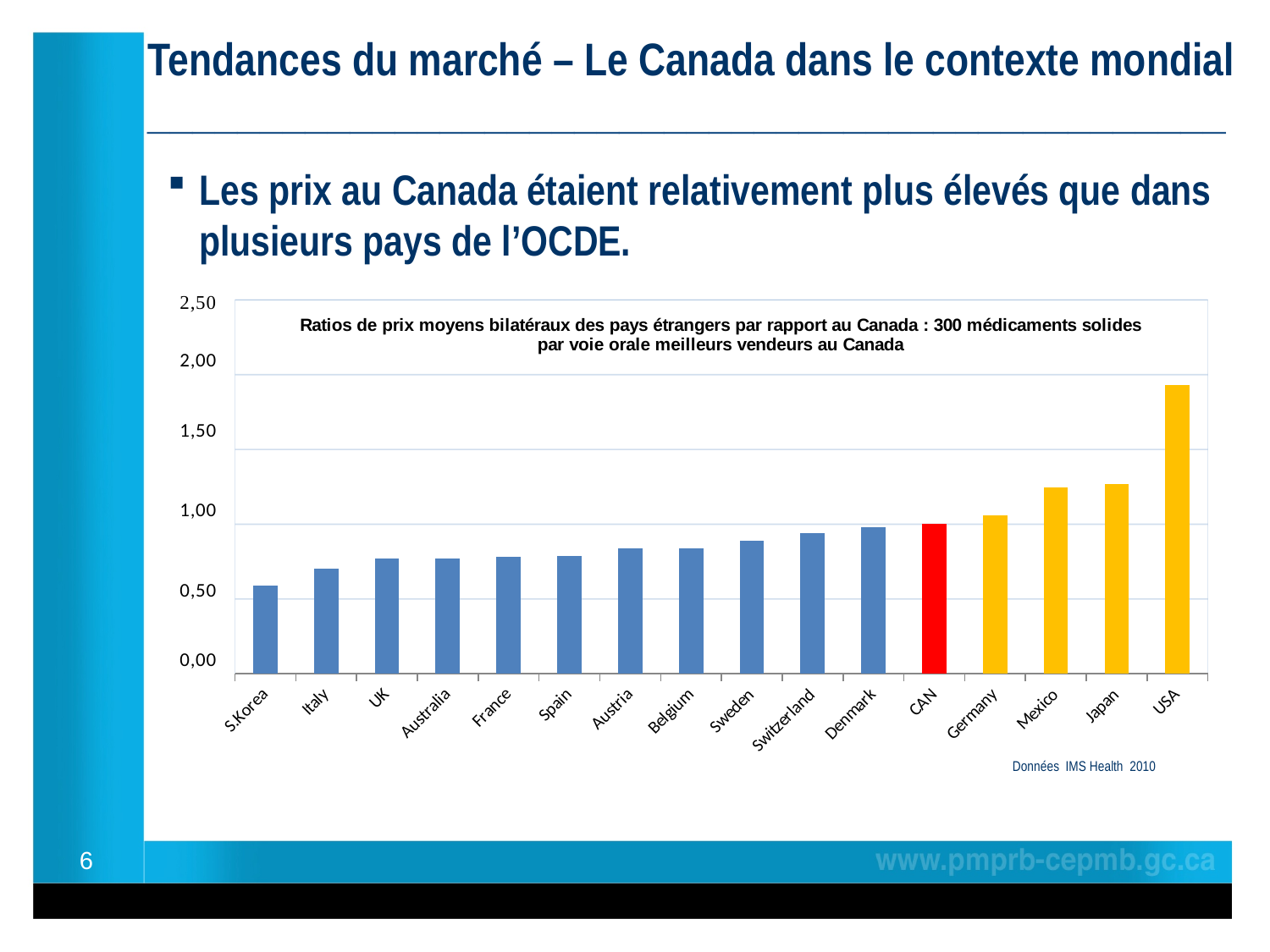
What kind of chart is shown on the slide? bar chart Do the bar values rise or fall from left to right along the x axis? rise Which country has the highest price ratio in the chart? USA Which has the larger value, Mexico or Sweden? Mexico Which country has the lowest price ratio in the chart? S.Korea How many countries are shown on the x axis of the chart? 16 What colour is the bar for CAN? red Which has the larger value, USA or Japan? USA Is the value for Italy greater or less than 0,50? greater Is the value for USA greater or less than 1,50? greater Is the value for Japan greater or less than 1,00? greater